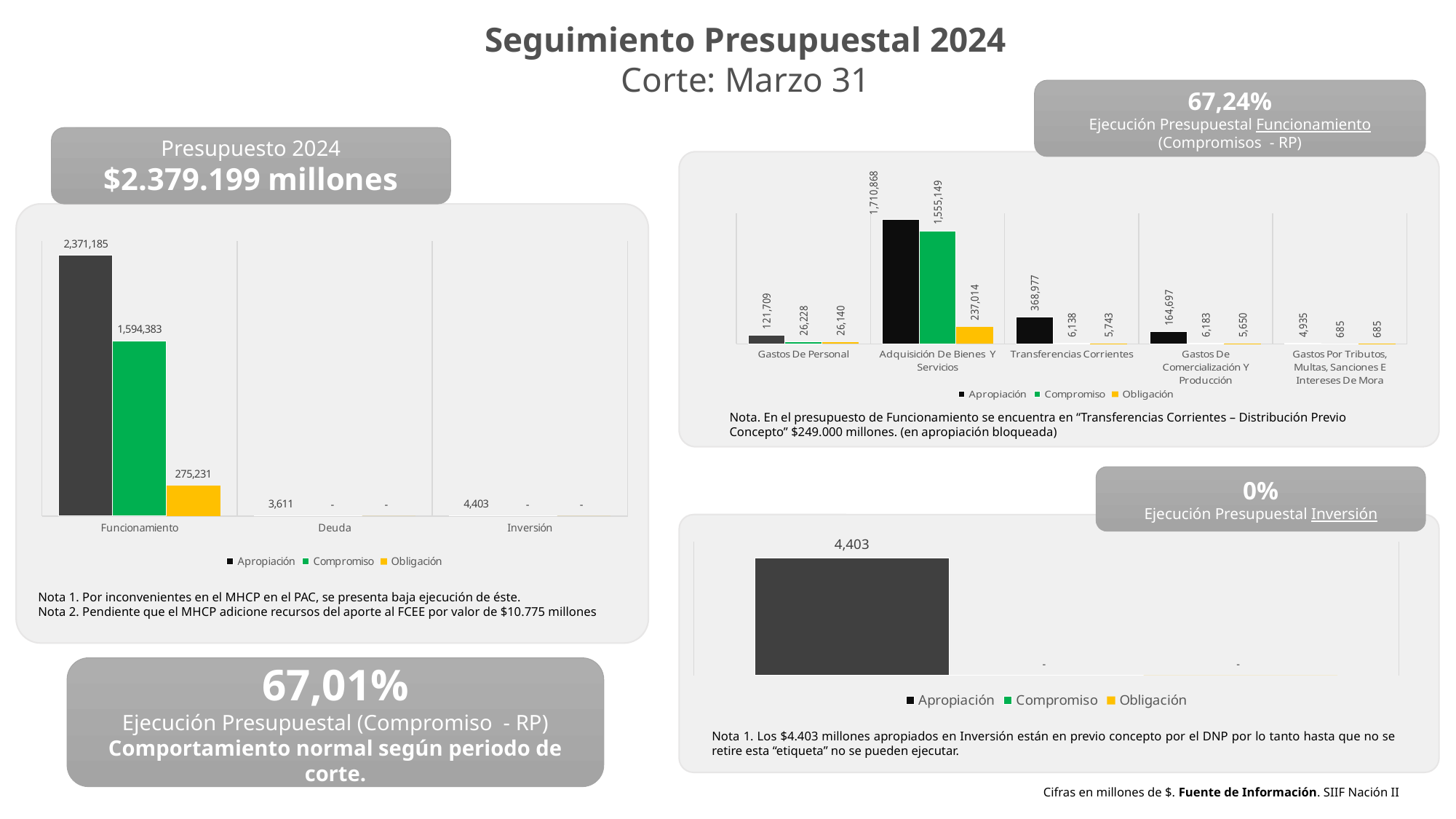
On the chart at the left of the slide, what is the Apropiación value for Deuda? 3,611 What kind of chart is the chart at the left of the slide? Bar chart On the chart at the top right of the slide, what is the Apropiación value for Transferencias Corrientes? 368,977 On the chart at the left of the slide, what is the Obligación value for Funcionamiento? 275,231 On the chart at the left of the slide, how many series does the legend list? 3 On the chart at the bottom right of the slide, what is the Apropiación value shown? 4,403 On the chart at the left of the slide, what is the difference between the Apropiación and Compromiso values for Funcionamiento? 776,802 On the chart at the left of the slide, what is the Apropiación value for Funcionamiento? 2,371,185 On the chart at the top right of the slide, which category has the highest Apropiación value? Adquisición De Bienes Y Servicios On the chart at the top right of the slide, what is the Compromiso value for Adquisición De Bienes Y Servicios? 1,555,149 On the chart at the top right of the slide, how many categories are shown on the x axis? 5 On the chart at the top right of the slide, which category has the lowest Apropiación value? Gastos Por Tributos, Multas, Sanciones E Intereses De Mora